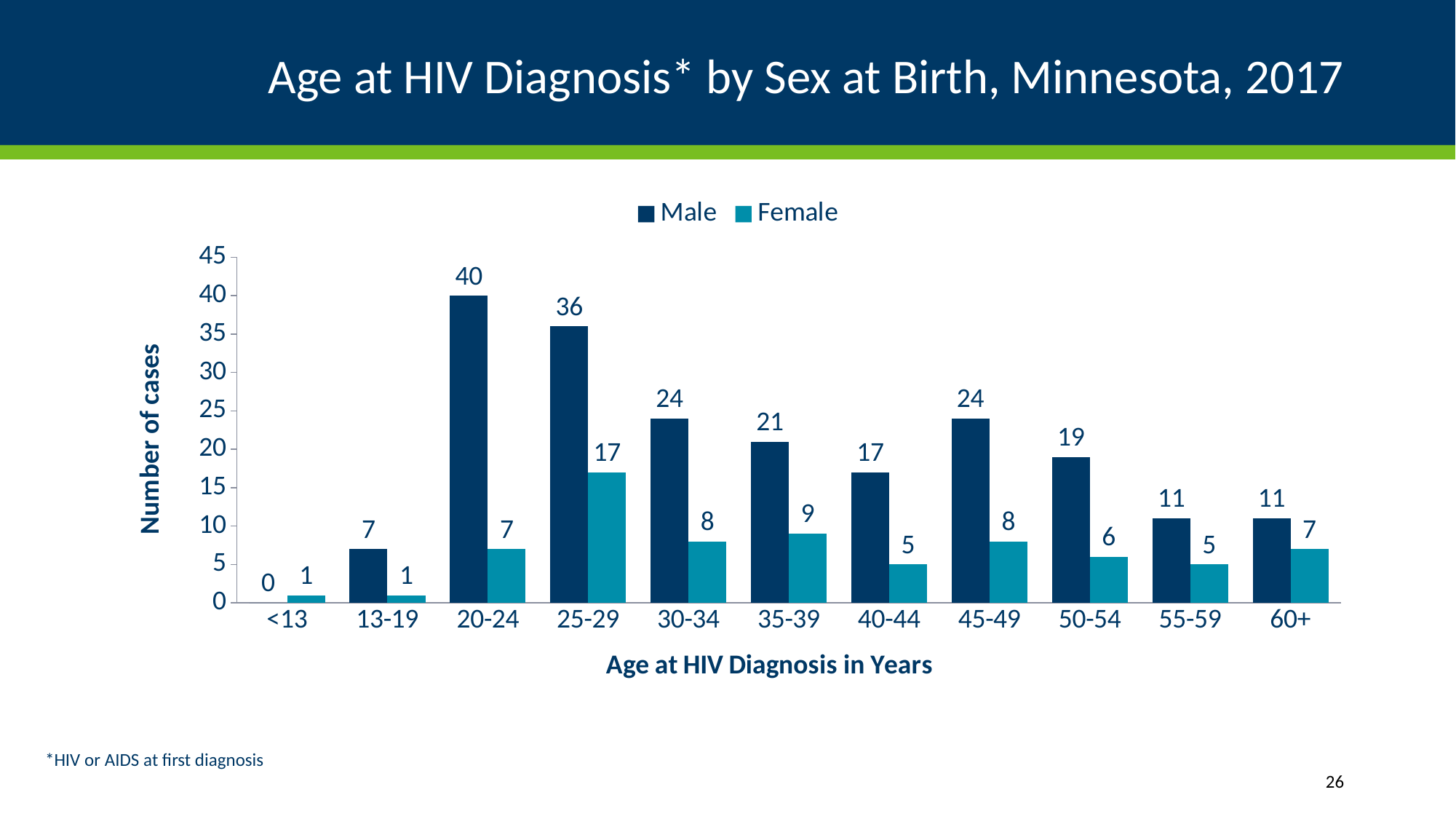
What kind of chart is shown on the slide? Bar chart How many series does the legend list? 2 What is the label of the y axis? Number of cases How many age groups are shown on the x axis? 11 Which age group has the highest number of Female cases? 25-29 Which is larger, the number of Male cases in the 35-39 age group or in the 45-49 age group? 45-49 Which age group has the highest number of Male cases? 20-24 What is the number of Male cases in the 50-54 age group? 19 What is the number of Female cases in the 25-29 age group? 17 What is the difference between Male and Female cases in the 30-34 age group? 16 Which age group has the lowest number of Male cases? <13 What is the number of Male cases in the 20-24 age group? 40